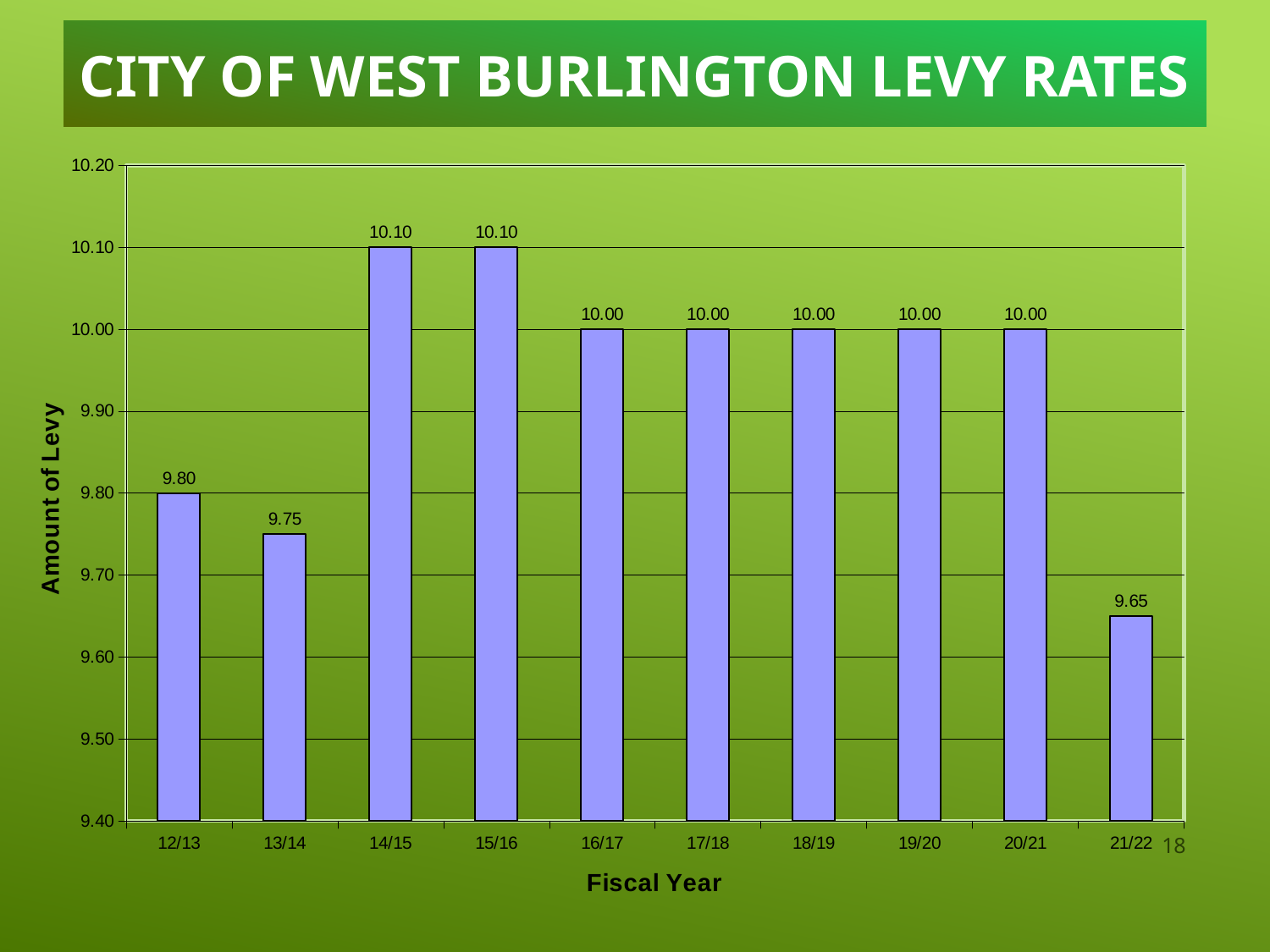
What is the difference between the levy rate in 14/15 and the levy rate in 13/14? 0.35 Which fiscal year has the lowest levy rate? 21/22 What is the title of the chart? CITY OF WEST BURLINGTON LEVY RATES What is the levy rate for fiscal year 13/14? 9.75 How many fiscal years are shown on the chart? 10 What is the difference between the levy rate in 20/21 and the levy rate in 21/22? 0.35 Does the levy rate rise or fall from 15/16 to 16/17? Fall Which is larger, the levy rate for 12/13 or the levy rate for 13/14? 12/13 What is the levy rate for fiscal year 21/22? 9.65 What is the levy rate for fiscal year 12/13? 9.80 What is the highest levy rate shown on the chart? 10.10 What kind of chart is shown on the slide? Bar chart